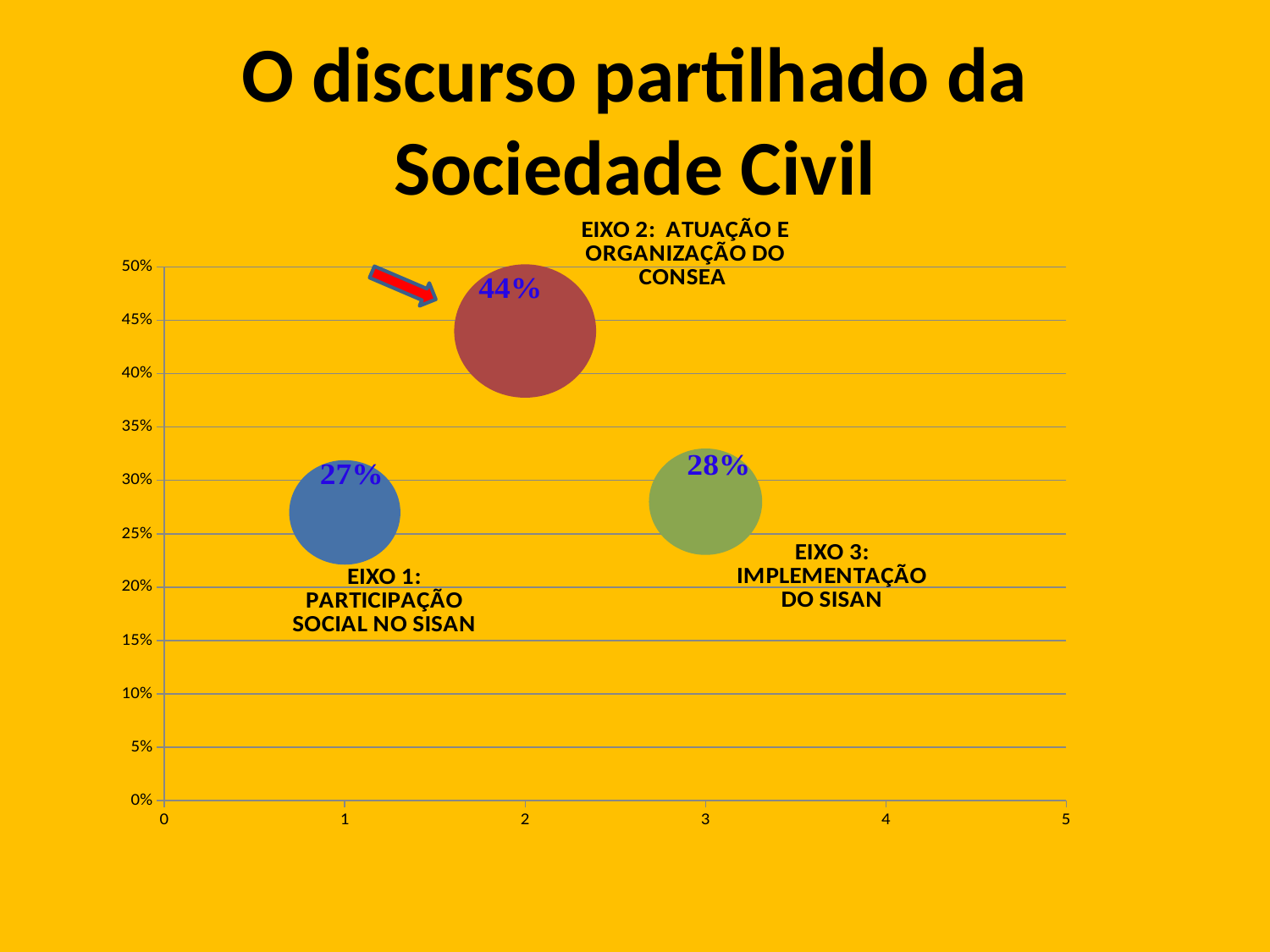
What is the difference between the values for EIXO 2 and EIXO 1? 17 percentage points What value is shown for EIXO 1: PARTICIPAÇÃO SOCIAL NO SISAN? 27% Which eixo has the lowest value on the chart? EIXO 1: PARTICIPAÇÃO SOCIAL NO SISAN What kind of chart is shown on the slide? Bubble chart How many bubbles (eixos) are plotted on the chart? 3 What is the title of the slide containing the chart? O discurso partilhado da Sociedade Civil What is the difference between the values for EIXO 3 and EIXO 1? 1 percentage point What value is shown for EIXO 2: ATUAÇÃO E ORGANIZAÇÃO DO CONSEA? 44% Is the value for EIXO 2 greater or less than 40%? greater Which has a larger value, EIXO 2 or EIXO 3? EIXO 2 What value is shown for EIXO 3: IMPLEMENTAÇÃO DO SISAN? 28% Which eixo has the highest value on the chart? EIXO 2: ATUAÇÃO E ORGANIZAÇÃO DO CONSEA